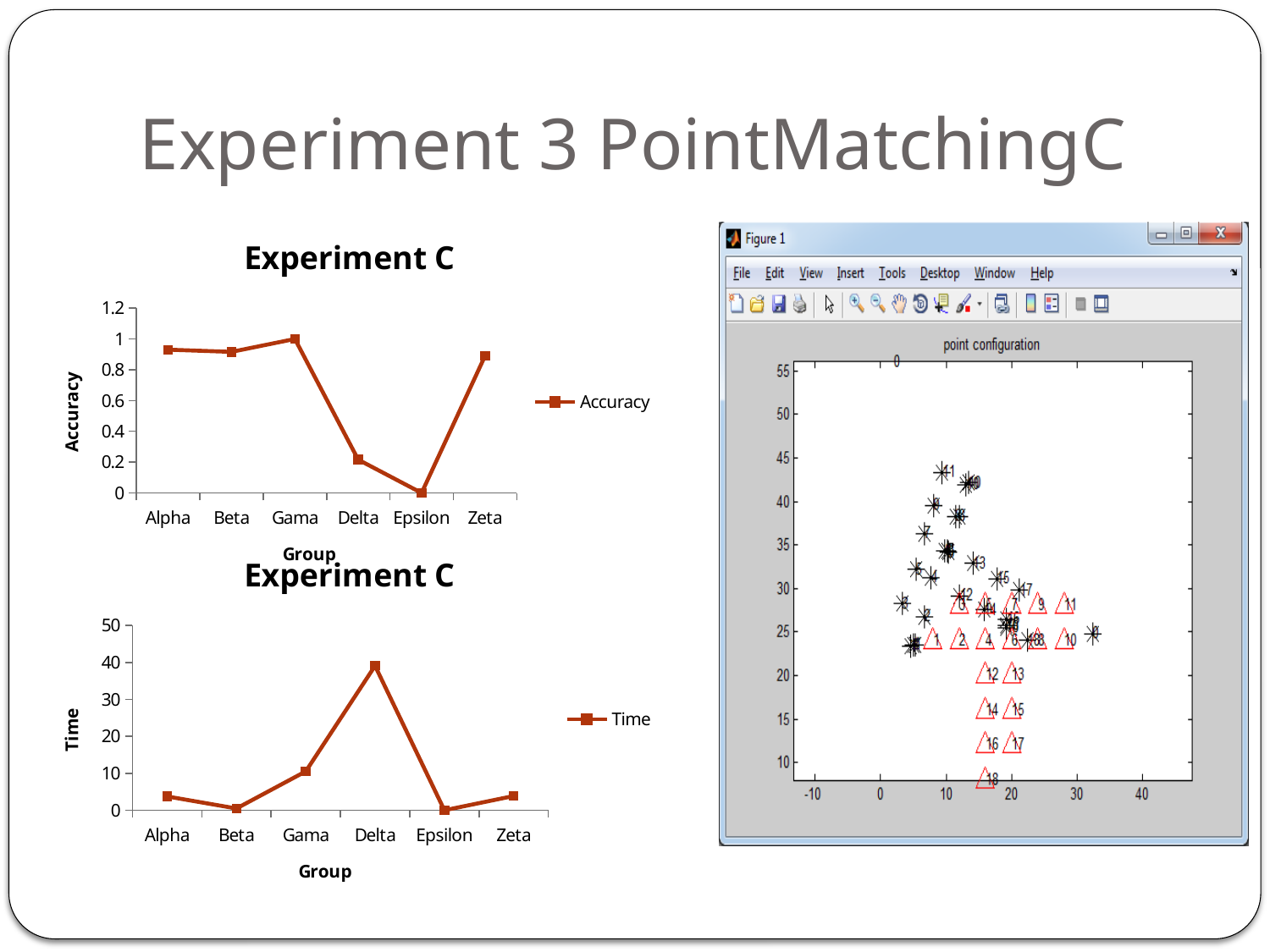
On the top chart (Accuracy), is the value for Zeta greater or less than 0.8? greater On the top chart (Accuracy), how many groups are plotted along the x axis? 6 On the bottom chart (Time), which has the higher time, Gama or Epsilon? Gama How many series does the legend of the top chart (Accuracy) list? 1 On the bottom chart (Time), is the value for Alpha greater or less than 10? less On the bottom chart (Time), which group has the highest time? Delta On the top chart (Accuracy), which has the higher accuracy, Alpha or Delta? Alpha On the top chart (Accuracy), which group has the lowest accuracy? Epsilon On the bottom chart (Time), is the value for Delta greater or less than 30? greater On the top chart (Accuracy), which group has the highest accuracy? Gama What kind of chart is the bottom chart (Time)? line chart